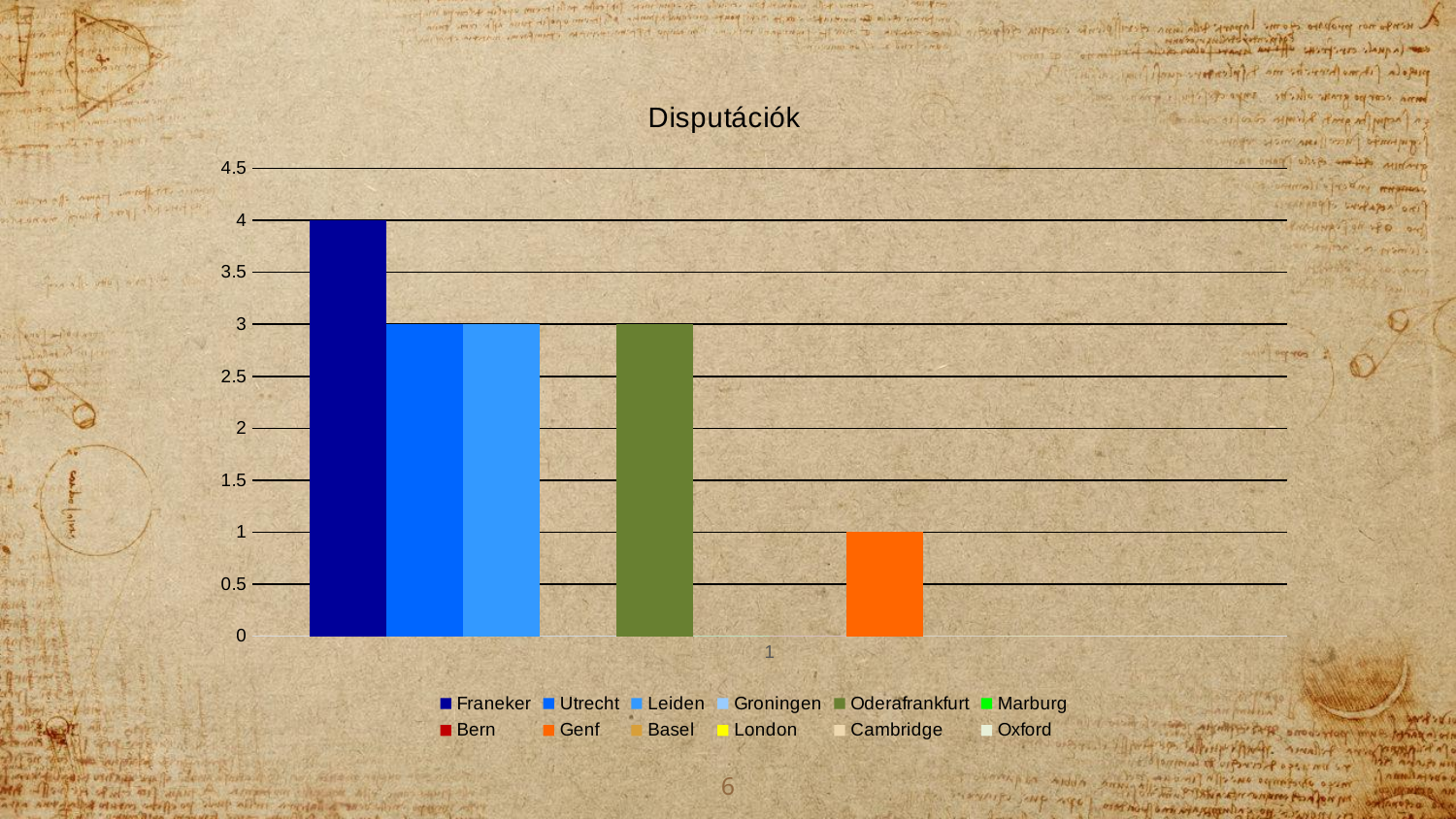
What is the value for Genf? 1 What is the difference between the values for Franeker and Genf? 3 What is the title of the chart? Disputációk What kind of chart is shown on the slide? bar chart What is the value for Franeker? 4 What is the value for Utrecht? 3 How many series does the legend list? 12 Is the value for Franeker greater or less than 3.5? greater Which series has the highest value? Franeker Which of the plotted series has the lowest value? Genf Which is larger, the value for Leiden or the value for Genf? Leiden What is the value for Oderafrankfurt? 3